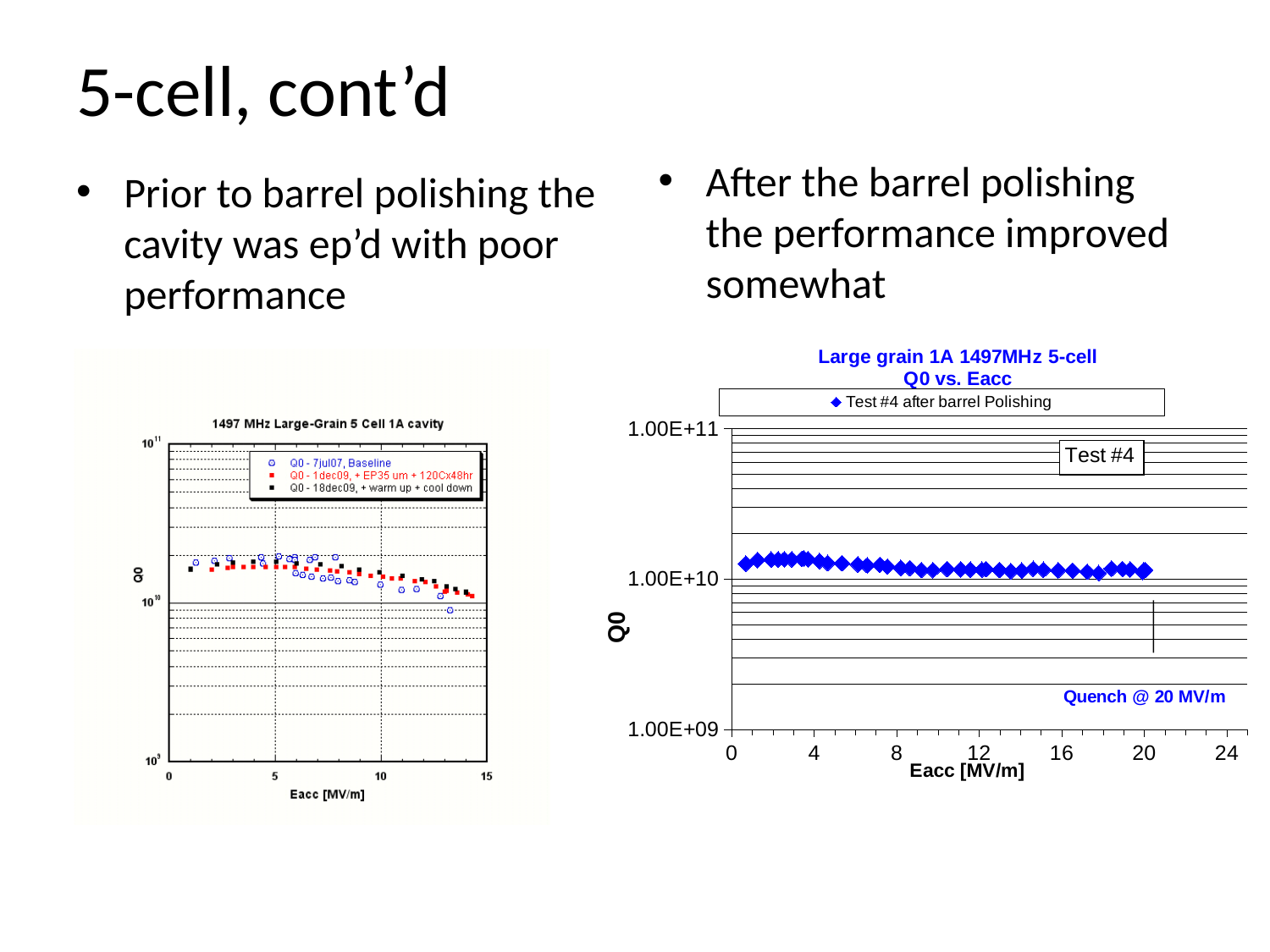
In the right-hand chart (Q0 vs. Eacc), is the Q0 value at Eacc = 4 MV/m greater or less than 1.00E+10? greater What kind of chart is the left-hand chart titled "1497 MHz Large-Grain 5 Cell 1A cavity"? scatter chart In the right-hand chart (Q0 vs. Eacc), is the Q0 value at Eacc = 20 MV/m greater or less than 1.00E+11? less What kind of chart is the right-hand chart titled "Large grain 1A 1497MHz 5-cell Q0 vs. Eacc"? scatter chart In the left-hand chart (1497 MHz Large-Grain 5 Cell 1A cavity), do the Q0 values rise or fall as Eacc increases from 8 to 14 MV/m? fall In the right-hand chart (Q0 vs. Eacc), what is the label of the x axis? Eacc [MV/m] In the right-hand chart (Q0 vs. Eacc), do the Q0 values rise or fall as Eacc increases from 4 to 20 MV/m? fall How many series does the legend of the right-hand chart (Q0 vs. Eacc) list? 1 In the right-hand chart (Q0 vs. Eacc), at what Eacc value does the annotation say the cavity quenched? 20 MV/m In the right-hand chart (Q0 vs. Eacc), what is the name of the series shown in the legend? Test #4 after barrel Polishing In the left-hand chart (1497 MHz Large-Grain 5 Cell 1A cavity), is the Q0 value of the baseline series at Eacc = 13 MV/m greater or less than 10^10? less How many series does the legend of the left-hand chart (1497 MHz Large-Grain 5 Cell 1A cavity) list? 3